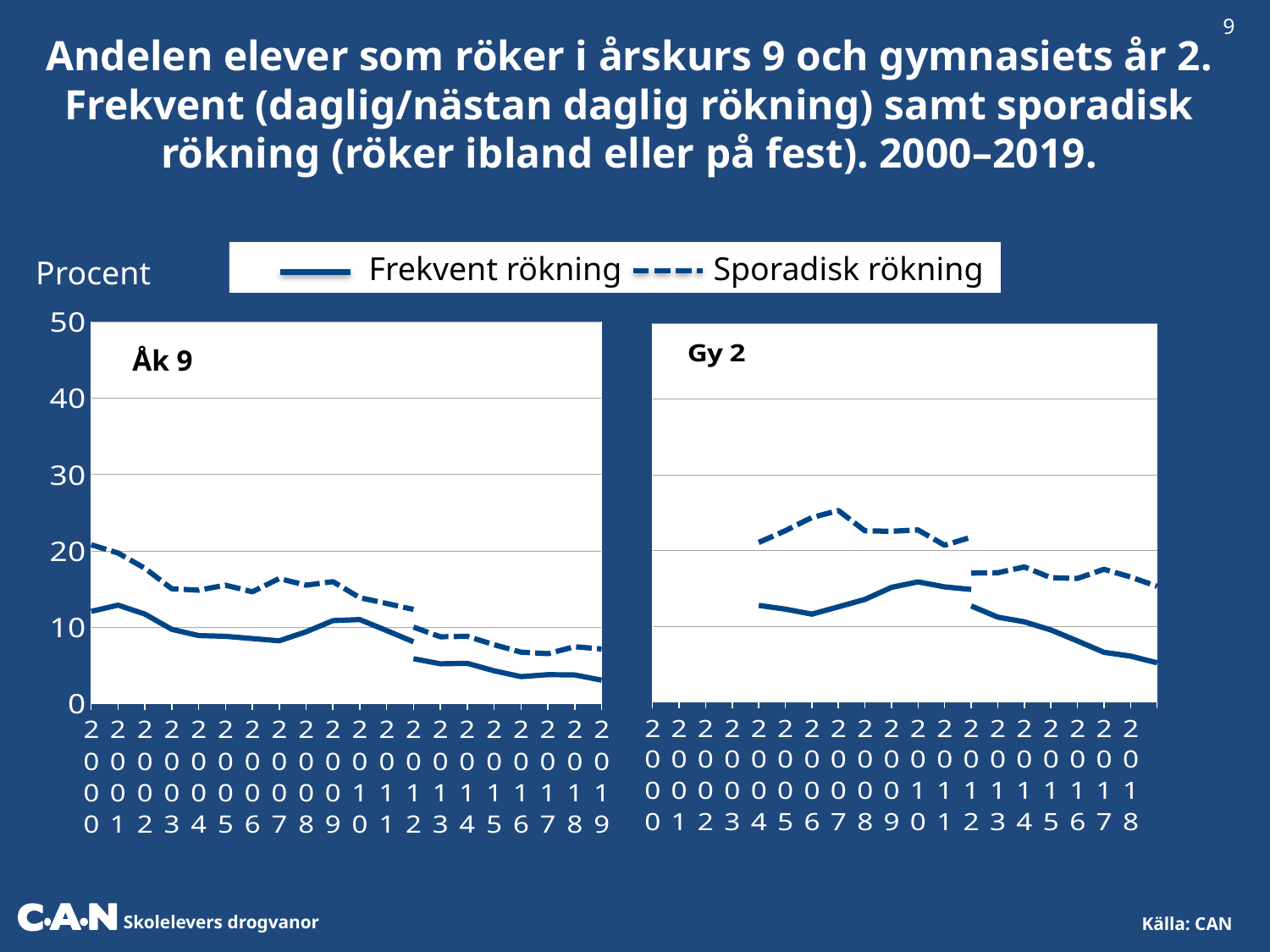
In the Åk 9 chart, does Frekvent rökning rise or fall from 2000 to 2019 overall? fall In the Åk 9 chart, is the value for Frekvent rökning in 2019 greater or less than 10? less How many series does the legend list? 2 In the Gy 2 chart, in which year does Sporadisk rökning reach its highest value? 2007 In the Gy 2 chart, which series has the larger value in 2007, Frekvent rökning or Sporadisk rökning? Sporadisk rökning How many years are labelled on the x axis of the Åk 9 chart? 20 In the Gy 2 chart, is the value for Frekvent rökning in 2018 greater or less than 10? less What kind of chart is the Åk 9 chart on the left? line chart In the Åk 9 chart, is the value for Sporadisk rökning in 2000 greater or less than 10? greater Which series is drawn with a dashed line in the legend? Sporadisk rökning What label is shown on the vertical axis of the charts? Procent